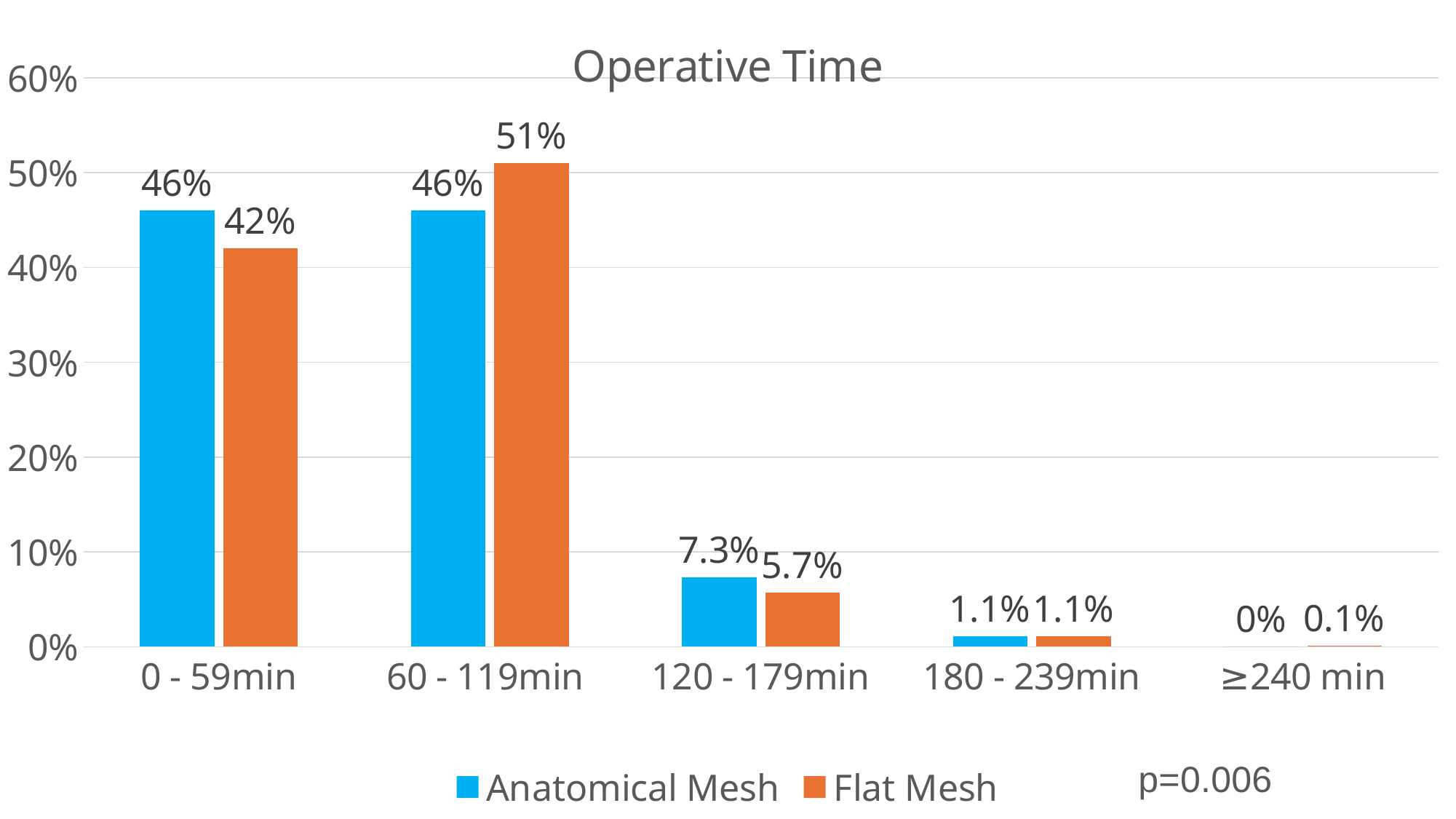
In the 0 - 59min category, which series has the larger value, Anatomical Mesh or Flat Mesh? Anatomical Mesh What is the difference between Flat Mesh and Anatomical Mesh in the 60 - 119min category? 5% How many series does the legend list? 2 What is the value for Anatomical Mesh in the 0 - 59min category? 46% What is the value for Flat Mesh in the 60 - 119min category? 51% What kind of chart is shown on the slide? Bar chart What is the title of the chart? Operative Time What is the value for Flat Mesh in the 120 - 179min category? 5.7% How many categories are shown on the x axis? 5 What is the value for Anatomical Mesh in the ≥240 min category? 0% Which category has the lowest value for Anatomical Mesh? ≥240 min Which category has the highest value for Flat Mesh? 60 - 119min